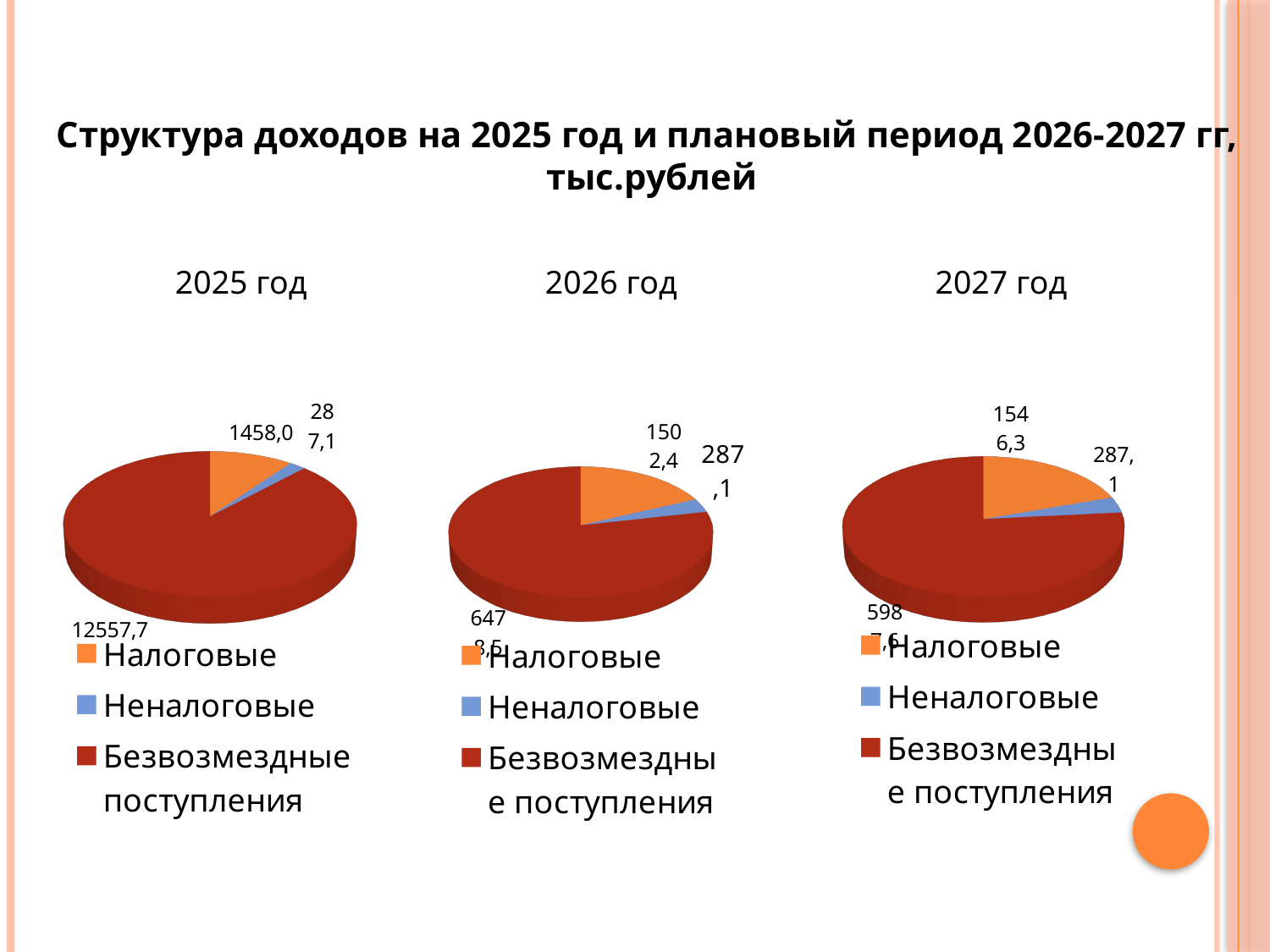
In the 2026 год pie chart, which category has the smallest slice? Неналоговые In the 2026 год pie chart, what is the value for Налоговые? 1502,4 Across the three pie charts, does the Налоговые value rise or fall from 2025 год to 2027 год? Rise In the 2025 год pie chart, which category has the largest slice? Безвозмездные поступления In the 2025 год pie chart, what is the value for Безвозмездные поступления? 12557,7 What kind of chart is used for 2025 год? Pie chart In the 2027 год pie chart, what is the value for Налоговые? 1546,3 How many slices does the 2026 год pie chart have? 3 In the 2027 год pie chart, what is the value for Неналоговые? 287,1 In the 2027 год pie chart, which is larger, Налоговые or Неналоговые? Налоговые In the 2025 год pie chart, what is the value for Налоговые? 1458,0 In the 2025 год pie chart, what is the difference between Налоговые and Неналоговые? 1170,9